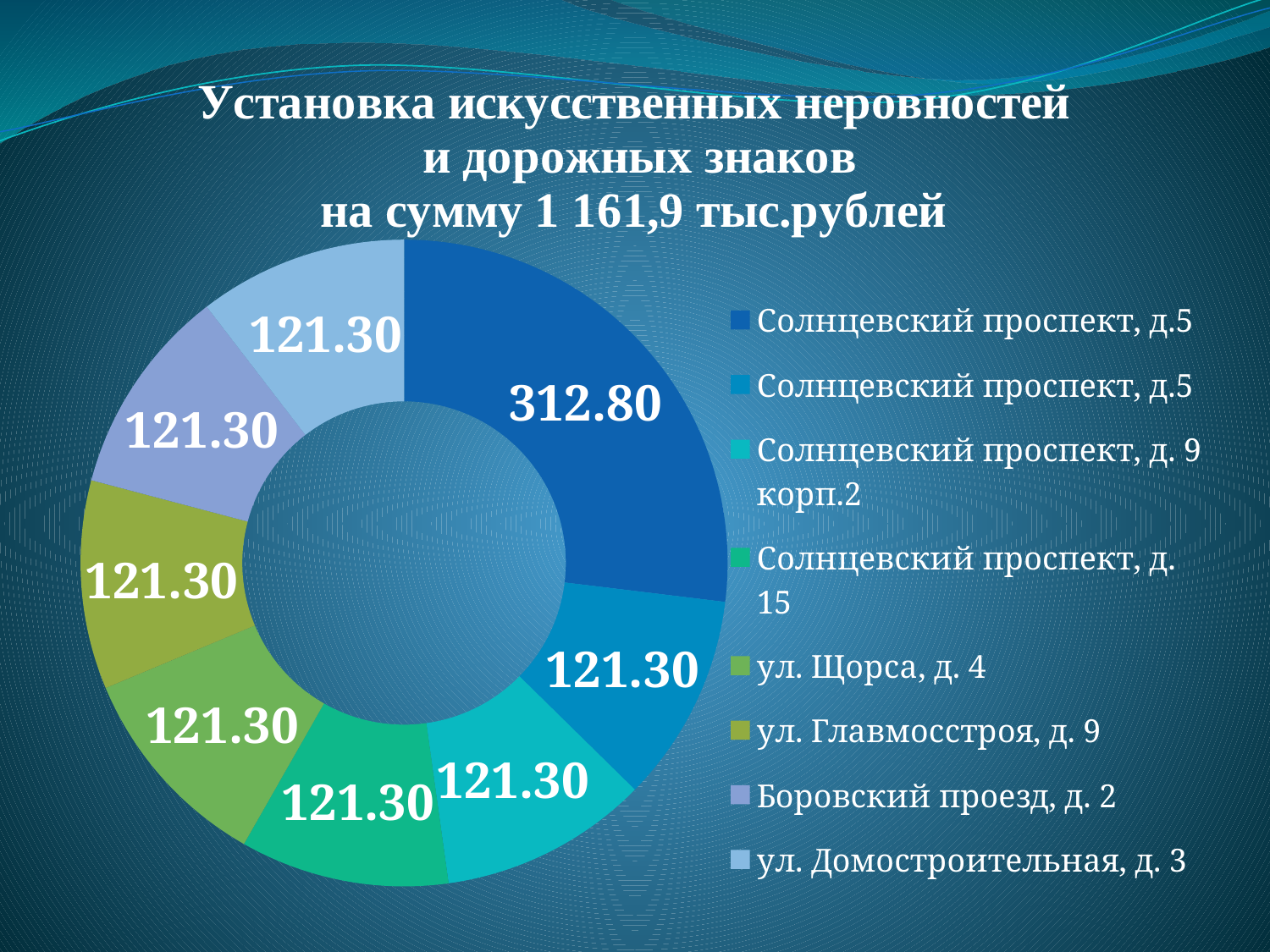
What kind of chart is shown on the slide? doughnut chart Which legend entry is listed last? ул. Домостроительная, д. 3 Which is larger: the slice labelled 312.80 or the slice for ул. Щорса, д. 4? the slice labelled 312.80 How many slices does the chart have? 8 What is the total of all slice values in the chart? 1161.90 What is the value of the largest slice in the chart? 312.80 What is the difference between the largest slice (312.80) and the slice for ул. Главмосстроя, д. 9? 191.50 What is the value for ул. Домостроительная, д. 3? 121.30 What is the value for Боровский проезд, д. 2? 121.30 What is the value for ул. Щорса, д. 4? 121.30 What total amount is stated in the slide title? 1 161,9 тыс.рублей How many entries does the legend list? 8